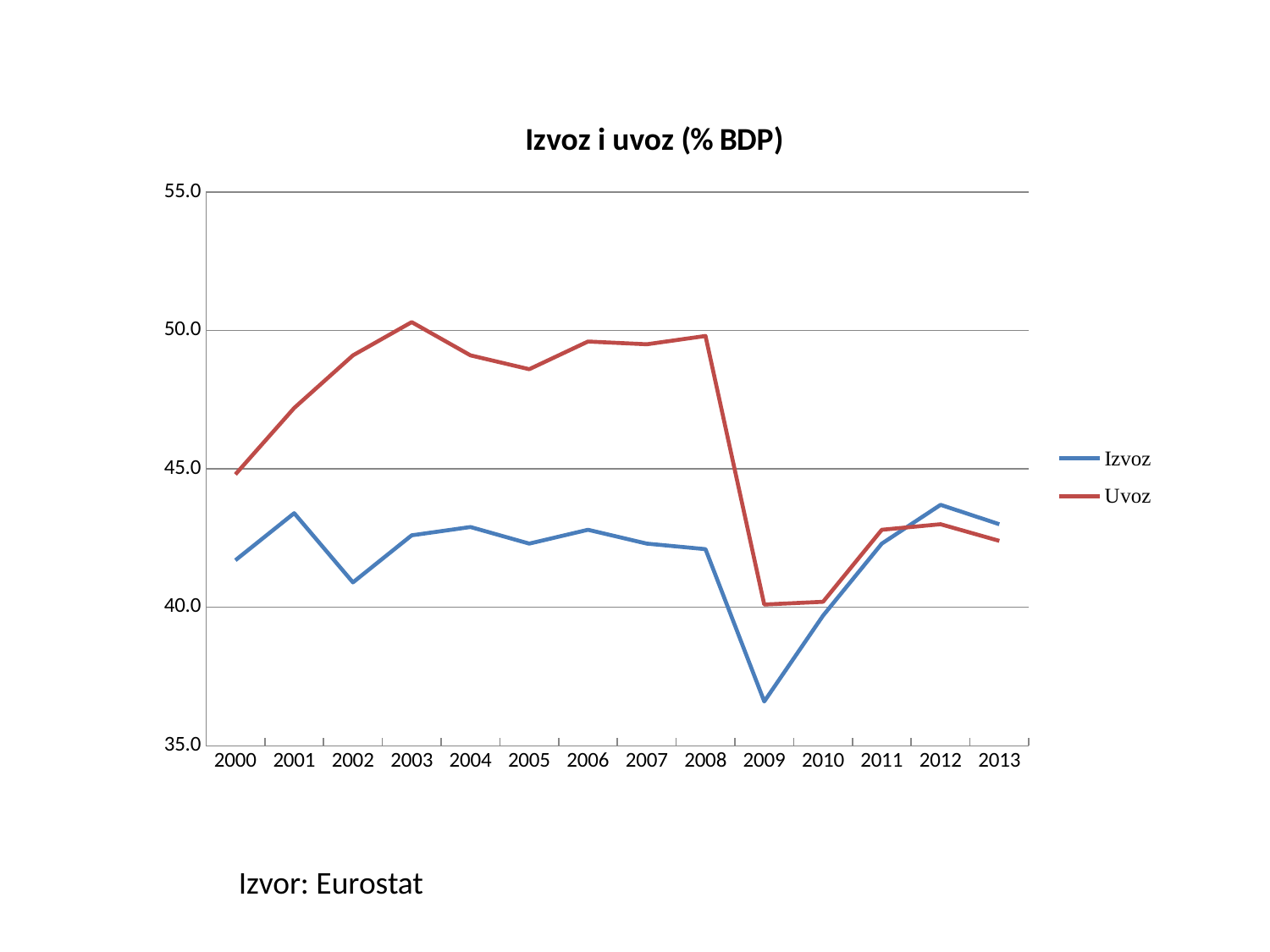
How many years are shown on the x axis? 14 Is the value for Uvoz in 2001 greater or less than 45.0? greater What is the title of the chart? Izvoz i uvoz (% BDP) Is the value for Izvoz in 2009 greater or less than 40.0? less In which year does the Izvoz series reach its lowest value? 2009 What kind of chart is shown on the slide? line chart Is the value for Uvoz in 2003 greater or less than 50.0? greater Does the Uvoz series rise or fall from 2000 to 2003? rise In 2008, which series has the larger value, Izvoz or Uvoz? Uvoz In which year does the Uvoz series reach its highest value? 2003 How many series does the legend list? 2